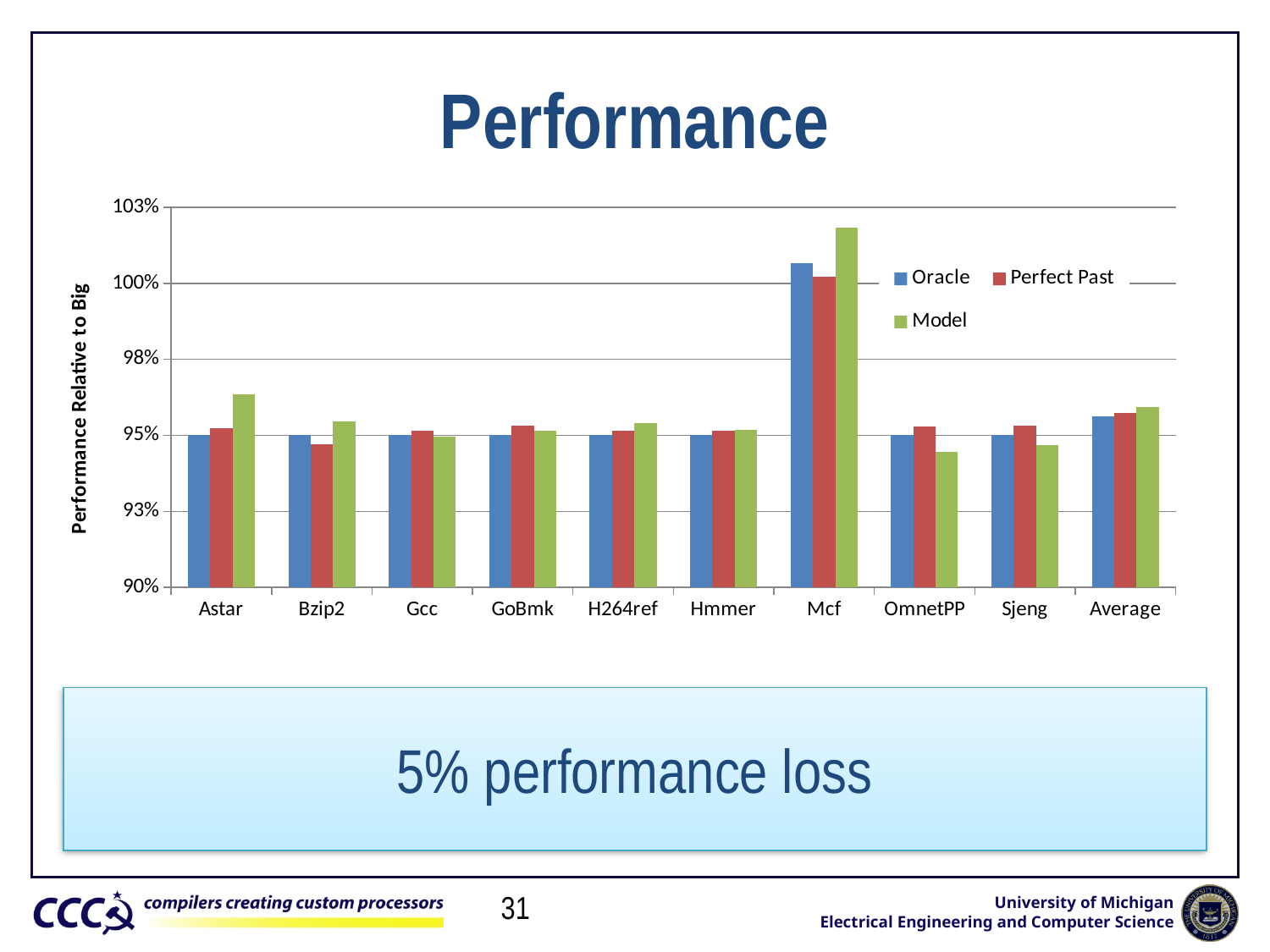
Which category has the highest Model value? Mcf What is the title of the chart? Performance How many categories are shown along the x axis of the chart? 10 Which category has the highest Oracle value? Mcf Is the Model value for OmnetPP greater or less than 95%? less What is the label of the vertical axis? Performance Relative to Big For Mcf, which is larger: the Perfect Past value or the Model value? Model Is the Model value for Mcf greater or less than 100%? greater For Astar, which is larger: the Oracle value or the Model value? Model Is the Perfect Past value for Mcf greater or less than 98%? greater How many series does the chart's legend list? 3 What kind of chart is shown on the slide? bar chart